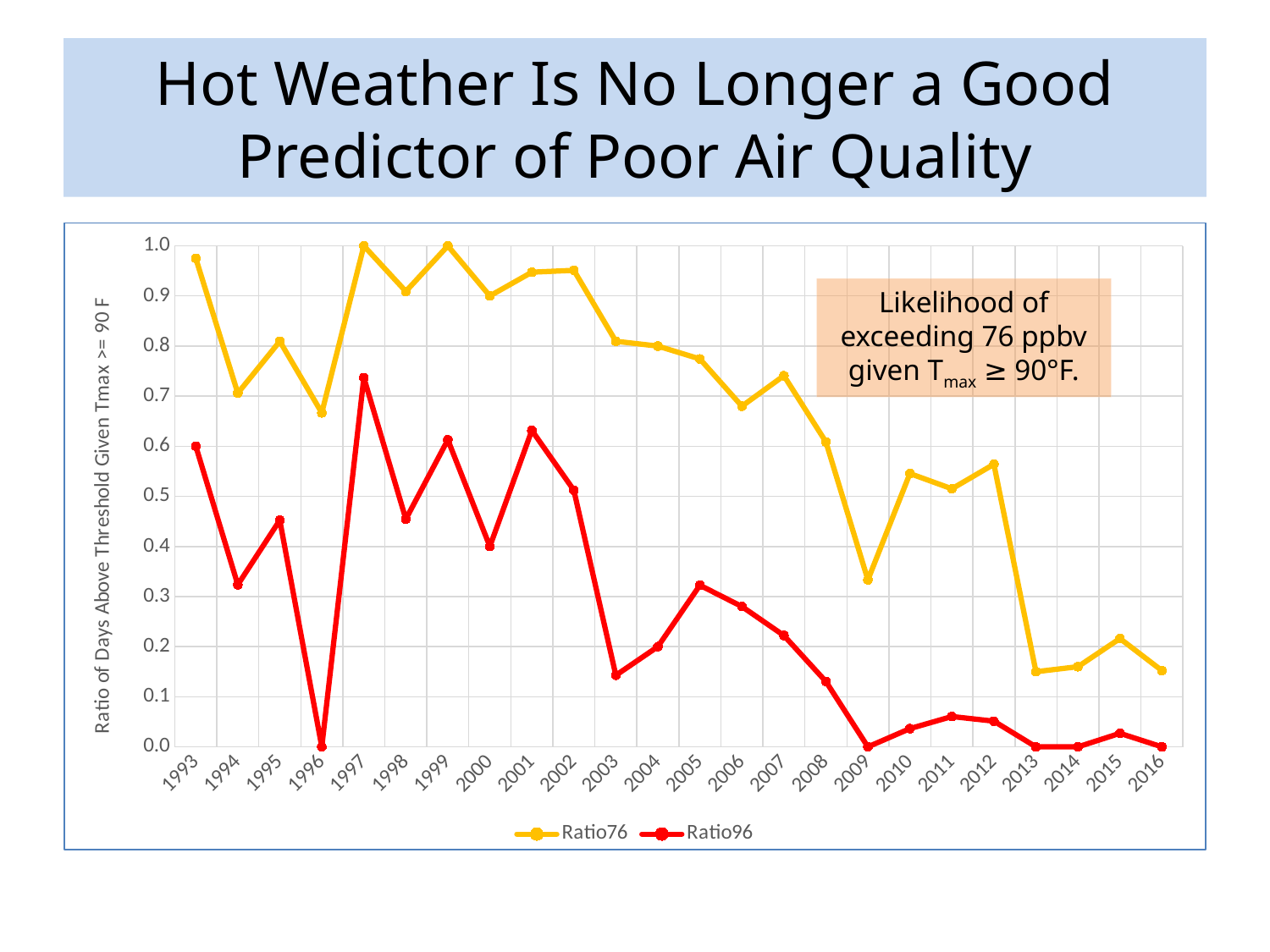
How many series does the legend list? 2 What are the two series named in the legend? Ratio76 and Ratio96 How many years are plotted along the x axis? 24 In which year does Ratio96 reach its highest value? 1997 Is the value of Ratio76 in 2009 greater or less than 0.4? less Does Ratio76 generally rise or fall from 1993 to 2016? Fall What type of chart is shown on the slide? Line chart Is the value of Ratio96 in 2003 greater or less than 0.2? less What is the value of Ratio96 in 1996? 0.0 Is the value of Ratio76 in 2012 greater or less than 0.5? greater What is the value of Ratio76 in 1997? 1.0 In 2005, which series has the larger value, Ratio76 or Ratio96? Ratio76